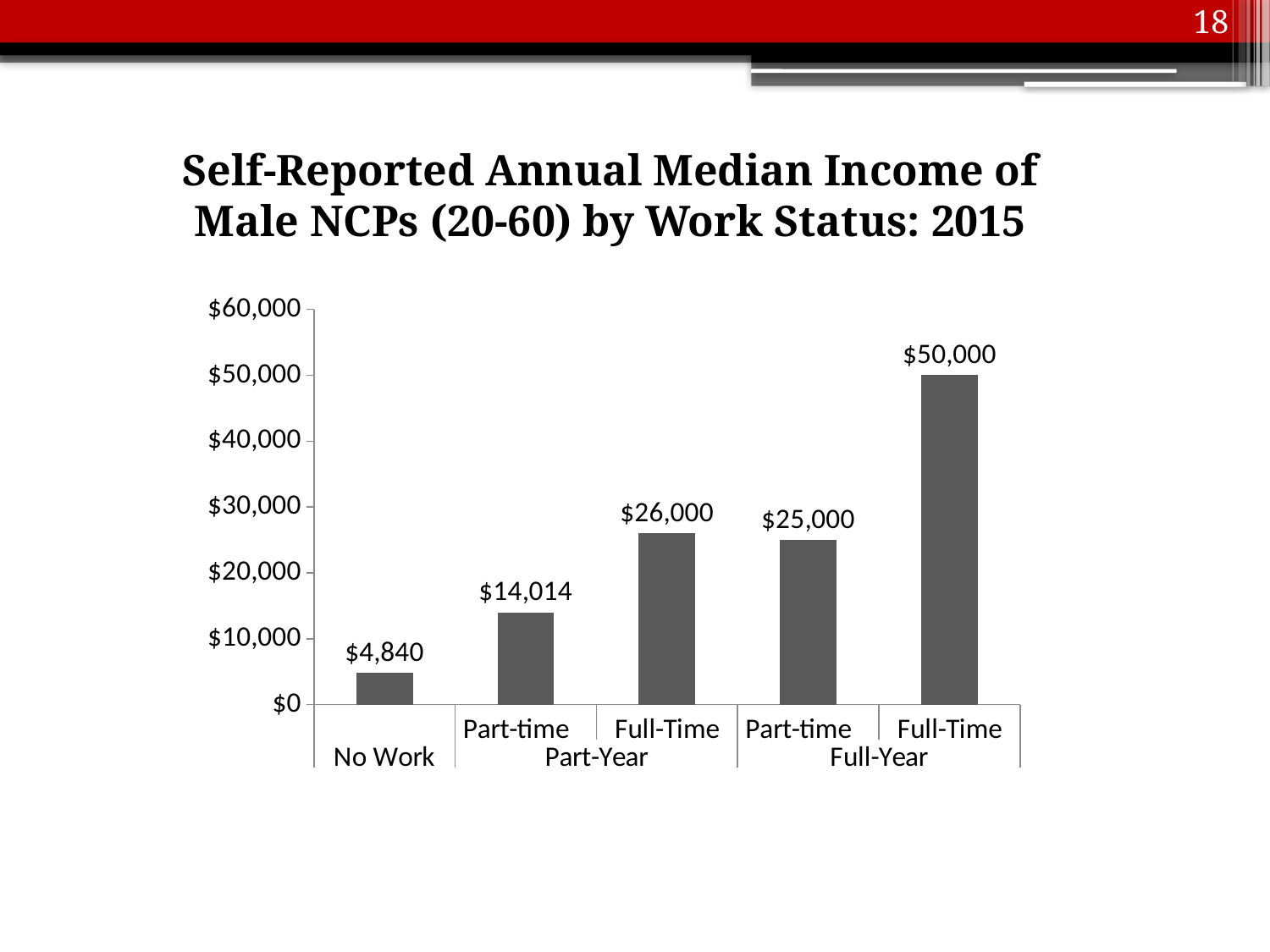
What is the title of the chart? Self-Reported Annual Median Income of Male NCPs (20-60) by Work Status: 2015 Is the value for Part-time, Part-Year greater or less than $10,000? greater Which work status category has the highest median income? Full-Time, Full-Year What is the median income for Part-time, Part-Year? $14,014 Which is larger: the median income for Full-Time, Part-Year or Part-time, Full-Year? Full-Time, Part-Year Which work status category has the lowest median income? No Work What is the difference between the Full-Time, Full-Year and Full-Time, Part-Year median incomes? $24,000 What type of chart is shown on the slide? Bar chart What is the median income for Full-Time, Full-Year? $50,000 What is the difference between the Part-time, Part-Year and No Work median incomes? $9,174 What is the median income for No Work? $4,840 How many bars are shown in the chart? 5